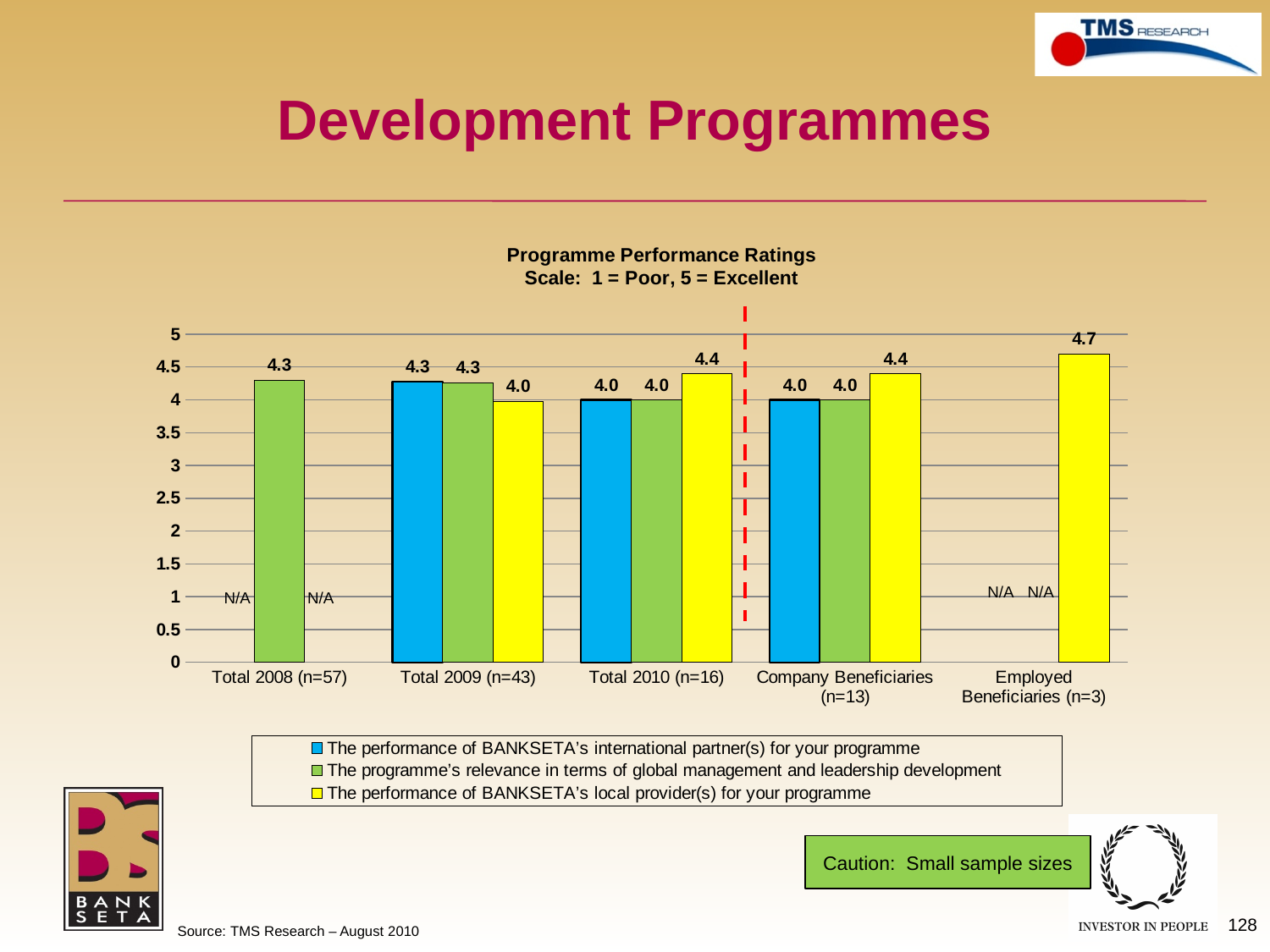
What is the rating for the performance of BANKSETA's local provider(s) for Total 2010 (n=16)? 4.4 What is the difference between the local provider(s) rating for Employed Beneficiaries (n=3) and for Total 2009 (n=43)? 0.7 What kind of chart is shown on the slide? Bar chart Which category has the lowest rating for the performance of BANKSETA's local provider(s)? Total 2009 (n=43) What is the rating for the performance of BANKSETA's local provider(s) among Employed Beneficiaries (n=3)? 4.7 What is the rating for the programme's relevance in terms of global management and leadership development for Total 2008 (n=57)? 4.3 What is the rating for the performance of BANKSETA's international partner(s) for Total 2009 (n=43)? 4.3 Which category has the highest rating for the performance of BANKSETA's local provider(s)? Employed Beneficiaries (n=3) How many series does the legend list? 3 What is the rating for the performance of BANKSETA's international partner(s) for Total 2008 (n=57)? N/A How many categories are shown on the x axis? 5 For Total 2010 (n=16), which is higher: the rating for the international partner(s) or the rating for the local provider(s)? The performance of BANKSETA's local provider(s) for your programme